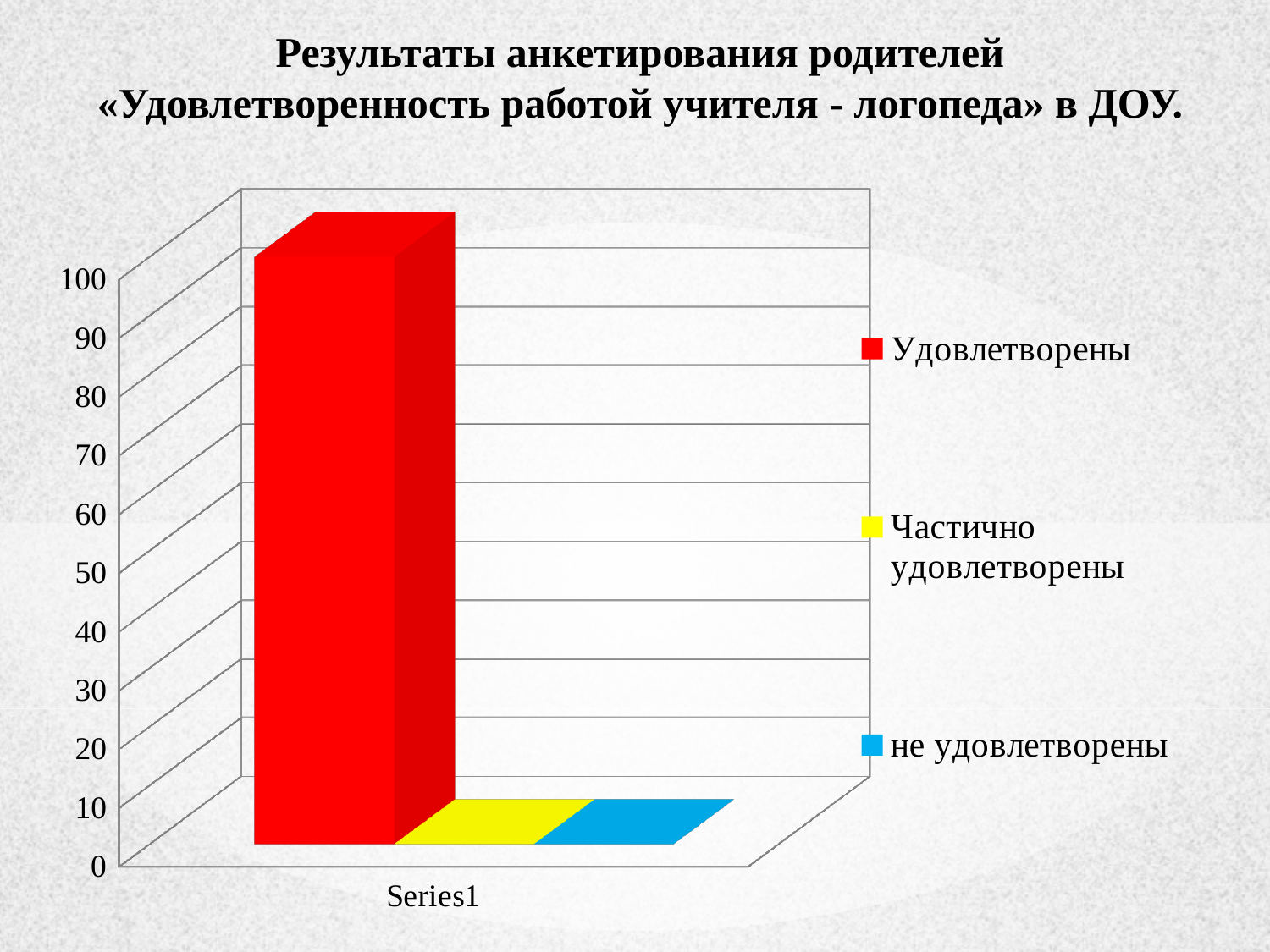
How many series does the legend list? 3 Which series has the highest value? Удовлетворены What kind of chart is shown on the slide? bar chart What is the label of the category on the x axis? Series1 How many categories are shown on the x axis? 1 Which colour represents the series Частично удовлетворены in the legend? yellow Which is larger, the value for Удовлетворены or the value for Частично удовлетворены? Удовлетворены Is the value for не удовлетворены greater or less than 10? less Is the value for Удовлетворены greater or less than 90? greater Which is larger, the value for Удовлетворены or the value for не удовлетворены? Удовлетворены Is the value for Частично удовлетворены greater or less than 10? less